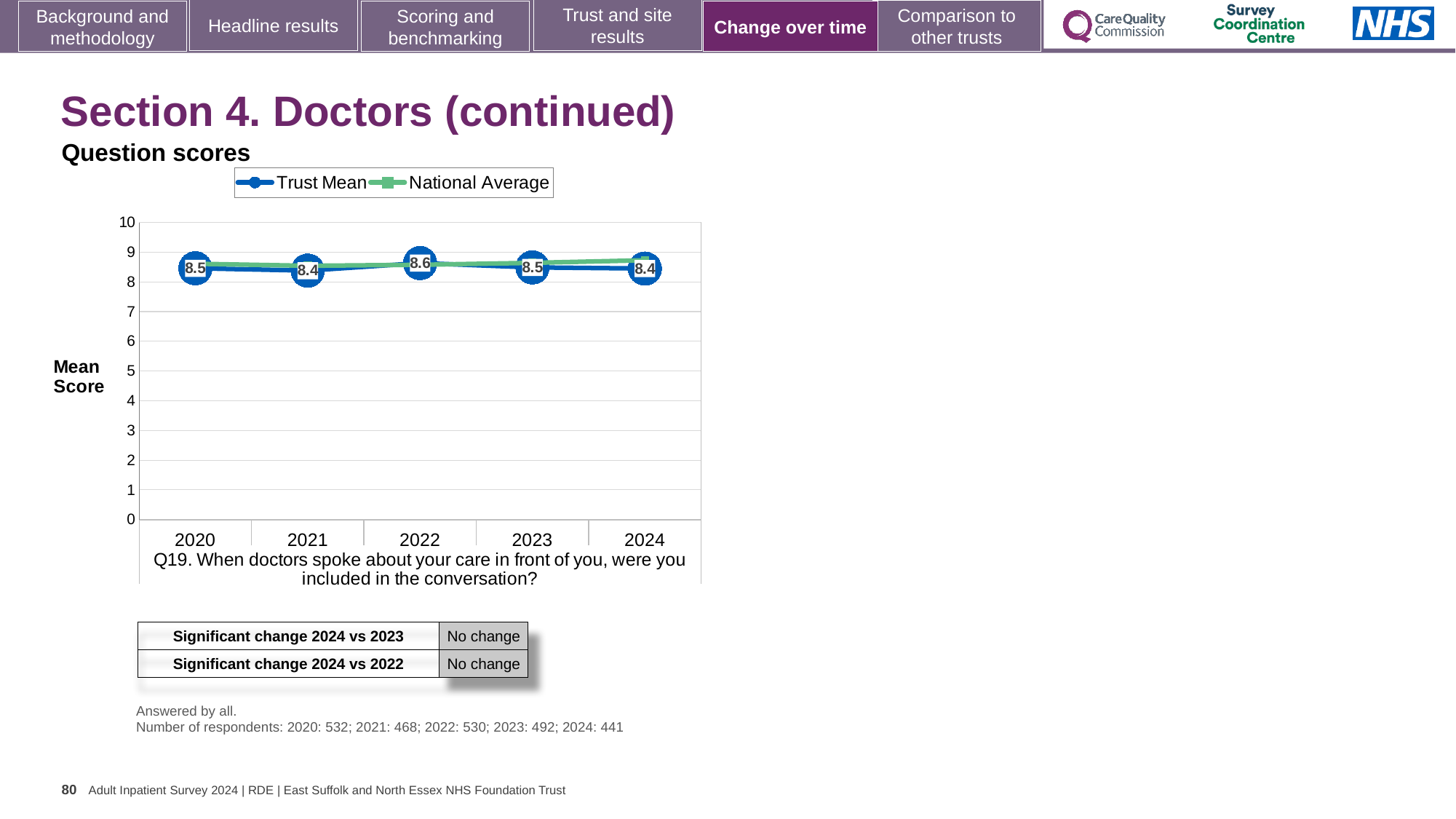
Which year has the larger Trust Mean score, 2022 or 2024? 2022 How many series does the legend list? 2 How many years are plotted on the x axis? 5 What is the difference between the Trust Mean scores for 2022 and 2021? 0.2 What is the Trust Mean score for 2020? 8.5 In which year is the Trust Mean score highest? 2022 What is the Trust Mean score for 2024? 8.4 What is the Trust Mean score for 2022? 8.6 Is the National Average value for 2024 greater or less than 7? greater What is the label on the y axis of the chart? Mean Score What kind of chart is shown? Line chart Does the Trust Mean score rise or fall from 2021 to 2022? Rise